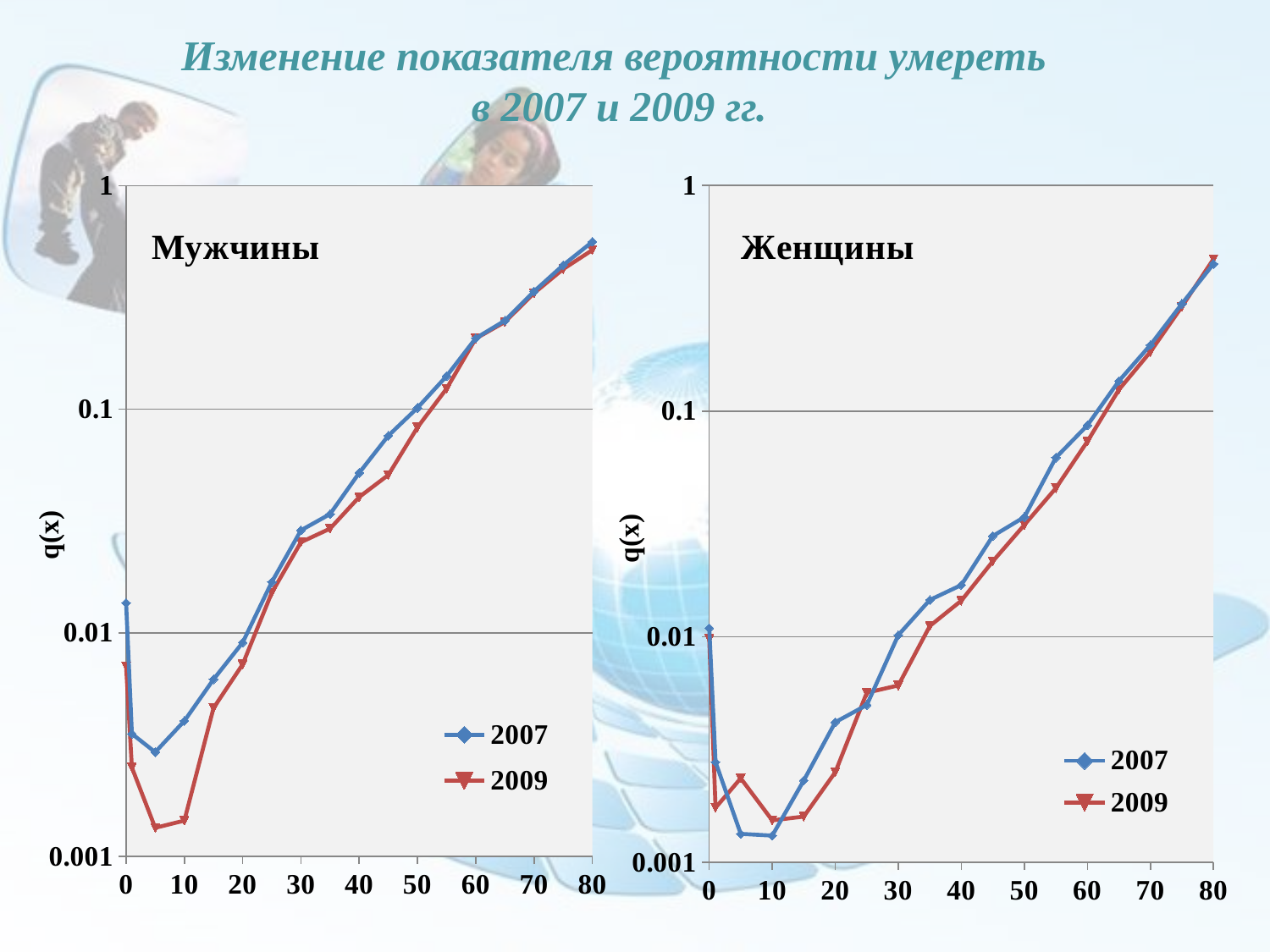
On the "Женщины" chart, is the 2009 value at age 10 greater or less than 0.01? less What are the legend entries on the "Мужчины" chart? 2007 and 2009 How many series does the legend of the "Женщины" chart list? 2 On the "Мужчины" chart, is the 2009 value at age 0 greater or less than 0.01? less On the "Женщины" chart, which series has the higher value at age 5, 2007 or 2009? 2009 On the "Женщины" chart, is the 2007 value at age 80 greater or less than 0.1? greater On the "Мужчины" chart, at which age does the 2009 series reach its lowest value? 5 What is the y-axis label on the "Женщины" chart? q(x) What kind of chart is the "Мужчины" chart? line chart On the "Мужчины" chart, which series has the higher value at age 10, 2007 or 2009? 2007 On the "Женщины" chart, do the 2007 values rise or fall from age 10 to age 80? rise